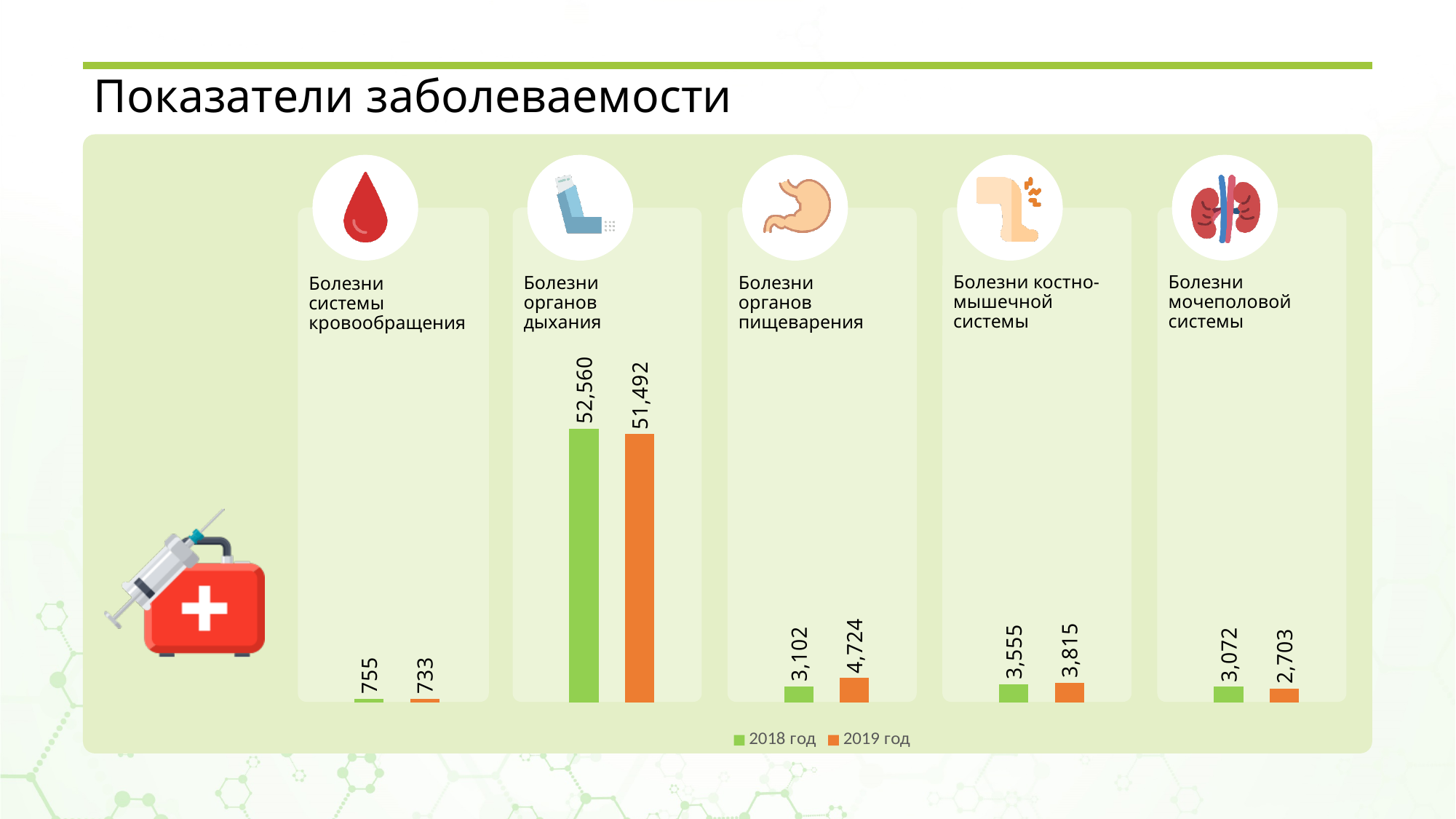
For Болезни мочеполовой системы, which is larger: the 2018 год value or the 2019 год value? 2018 год What is the difference between the 2018 год and 2019 год values for Болезни органов дыхания? 1,068 What is the 2018 год value for Болезни костно-мышечной системы? 3,555 What type of chart is shown on the slide? Bar chart What is the 2019 год value for Болезни органов пищеварения? 4,724 What is the 2019 год value for Болезни мочеполовой системы? 2,703 How many series does the legend list? 2 What is the difference between the 2019 год and 2018 год values for Болезни органов пищеварения? 1,622 Which category has the lowest 2018 год value? Болезни системы кровообращения What is the 2018 год value for Болезни органов дыхания? 52,560 How many disease categories are shown in the chart? 5 Which category has the highest 2019 год value? Болезни органов дыхания